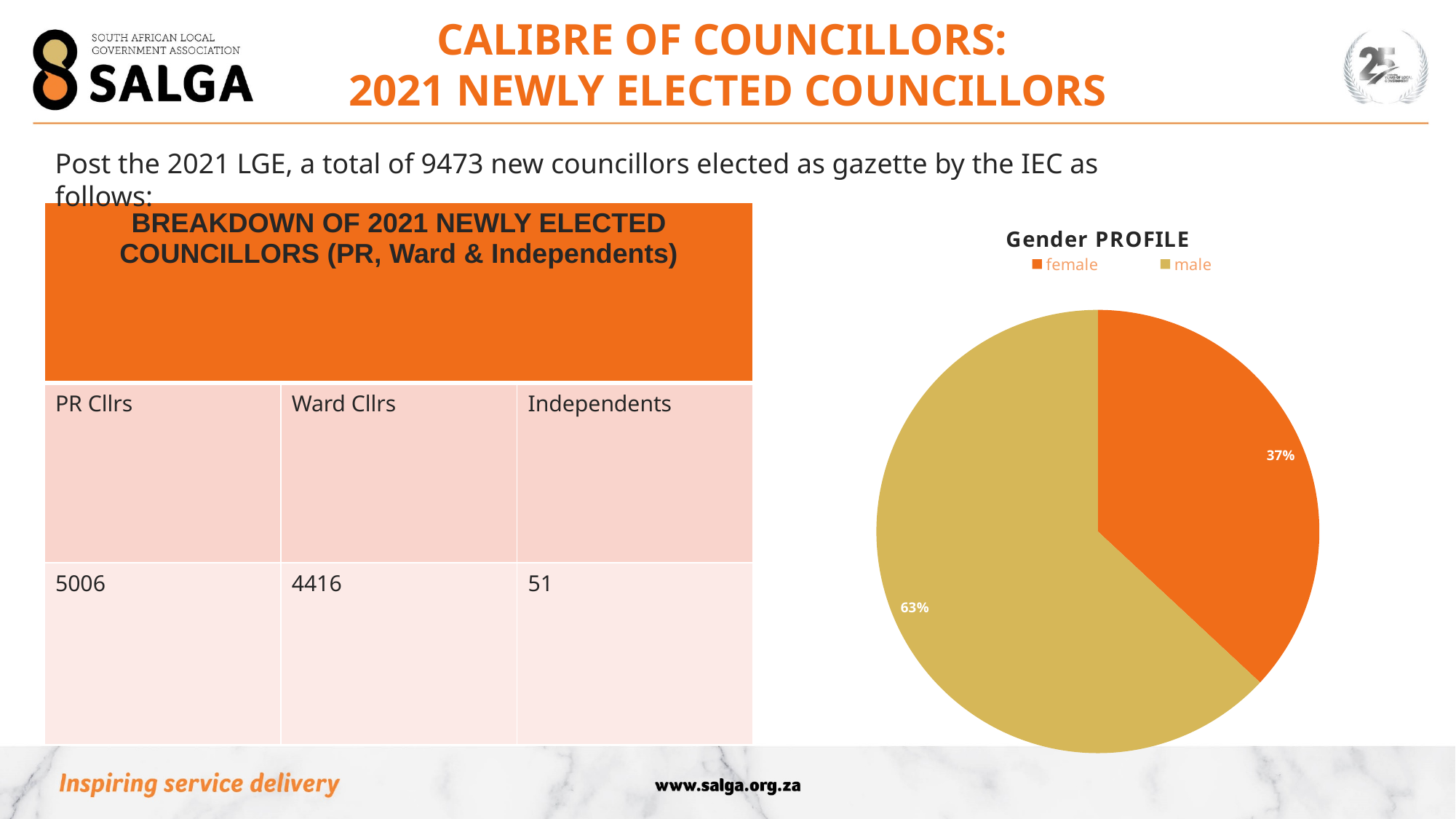
What kind of chart is the Gender PROFILE chart? pie chart In the Gender PROFILE chart, what is the difference in percentage points between the male and female slices? 26 percentage points In the Gender PROFILE chart, which slice is the largest? male In the Gender PROFILE chart, which slice is the smallest? female How many slices does the Gender PROFILE pie chart have? 2 What is the title of the pie chart on the slide? Gender PROFILE In the Gender PROFILE chart, what share of the pie is male? 63% In the Gender PROFILE chart, which is larger, the female slice or the male slice? male In the Gender PROFILE chart, what share of the pie is female? 37% In the Gender PROFILE chart, which colour represents the female slice? orange How many entries does the legend of the Gender PROFILE chart list? 2